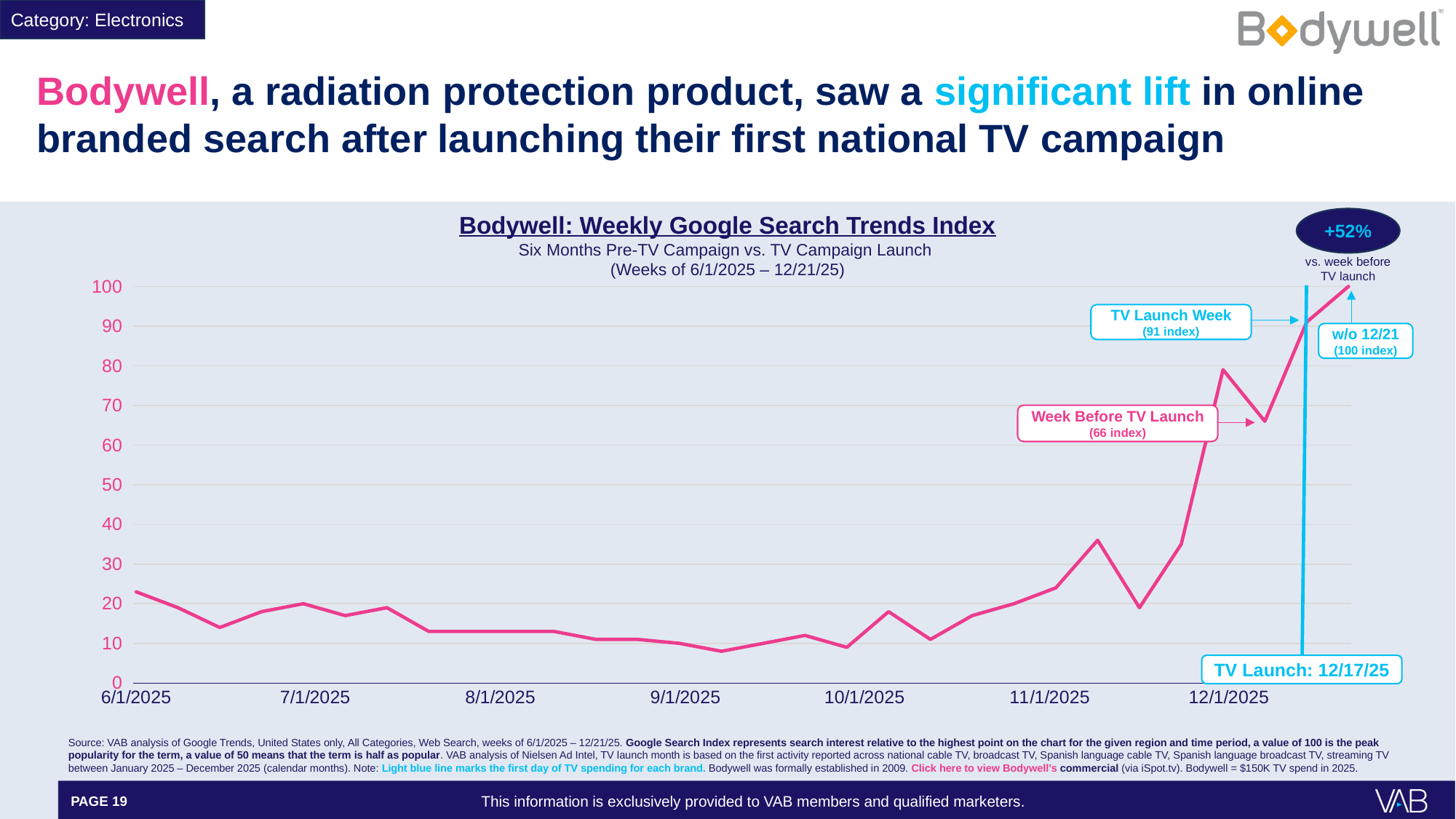
Which is larger, the TV Launch Week index or the Week Before TV Launch index? TV Launch Week What percentage lift vs. the week before TV launch is shown on the chart? +52% What is the index value for the Week Before TV Launch? 66 What kind of chart is shown on the slide? Line chart Which week has the highest index value on the chart? w/o 12/21 What is the difference between the w/o 12/21 index and the Week Before TV Launch index? 34 What is the index value for the week of 12/21 (w/o 12/21)? 100 Is the index value at 9/1/2025 greater or less than 20? less What is the index value for the TV Launch Week? 91 Does the search index generally rise or fall from 6/1/2025 to 12/21/2025? Rise Is the index value at 6/1/2025 greater or less than 30? less What is the difference between the TV Launch Week index and the Week Before TV Launch index? 25